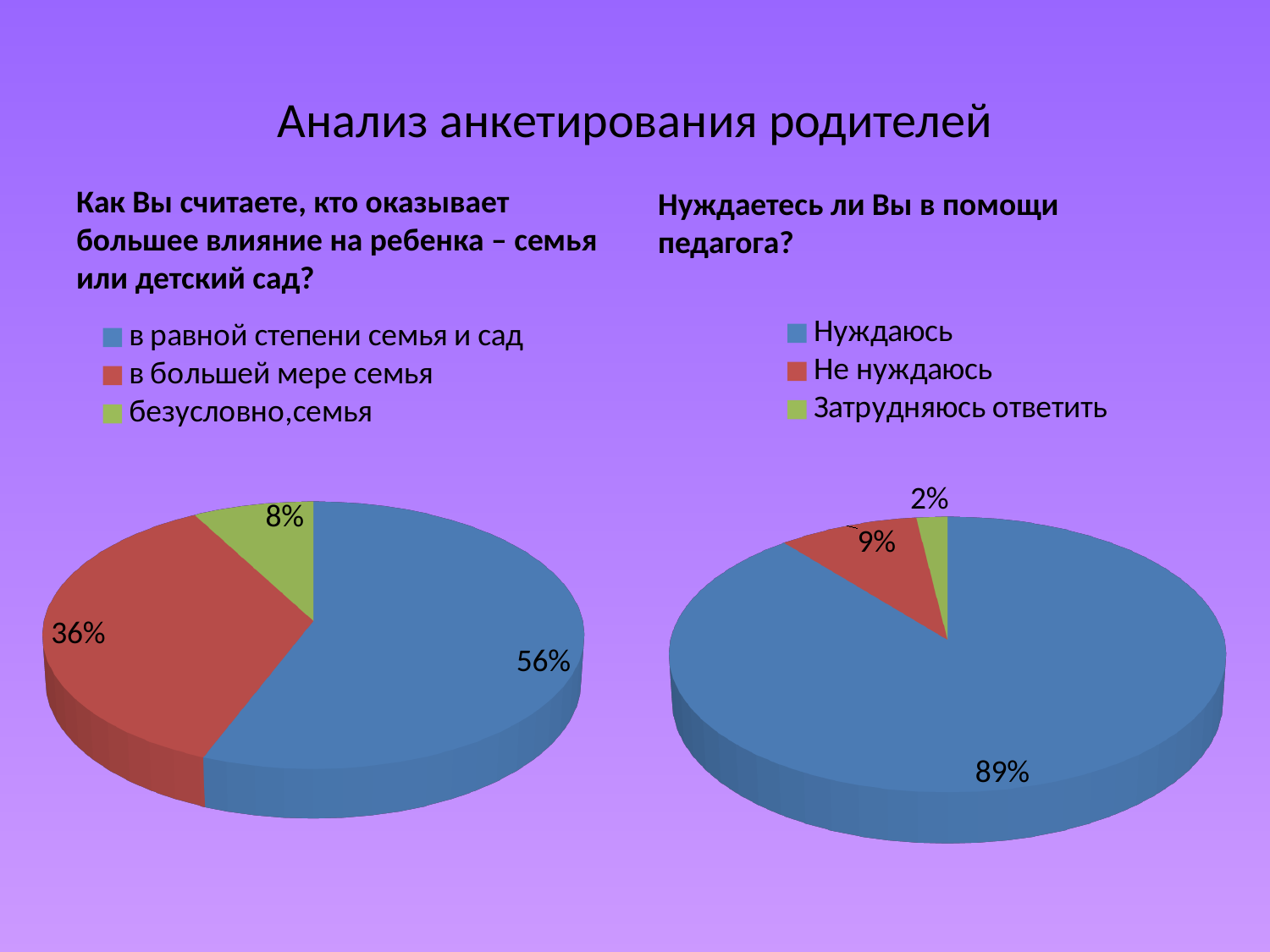
What type of chart is used on the left side of the slide? Pie chart In the left pie chart (family vs kindergarten influence), what is the difference in percentage points between 'в равной степени семья и сад' and 'в большей мере семья'? 20 In the right pie chart (need for teacher's help), what share is labelled for 'Затрудняюсь ответить'? 2% How many categories does the legend of the right pie chart (need for teacher's help) list? 3 In the right pie chart (need for teacher's help), which is larger: 'Не нуждаюсь' or 'Затрудняюсь ответить'? Не нуждаюсь In the left pie chart (family vs kindergarten influence), what share is labelled for 'безусловно,семья'? 8% In the left pie chart (family vs kindergarten influence), what share is labelled for 'в большей мере семья'? 36% In the right pie chart (need for teacher's help), what share is labelled for 'Не нуждаюсь'? 9% In the right pie chart (need for teacher's help), what share is labelled for 'Нуждаюсь'? 89% In the left pie chart (family vs kindergarten influence), which category has the largest share? в равной степени семья и сад In the left pie chart (family vs kindergarten influence), what share is labelled for 'в равной степени семья и сад'? 56% In the right pie chart (need for teacher's help), which category has the smallest share? Затрудняюсь ответить